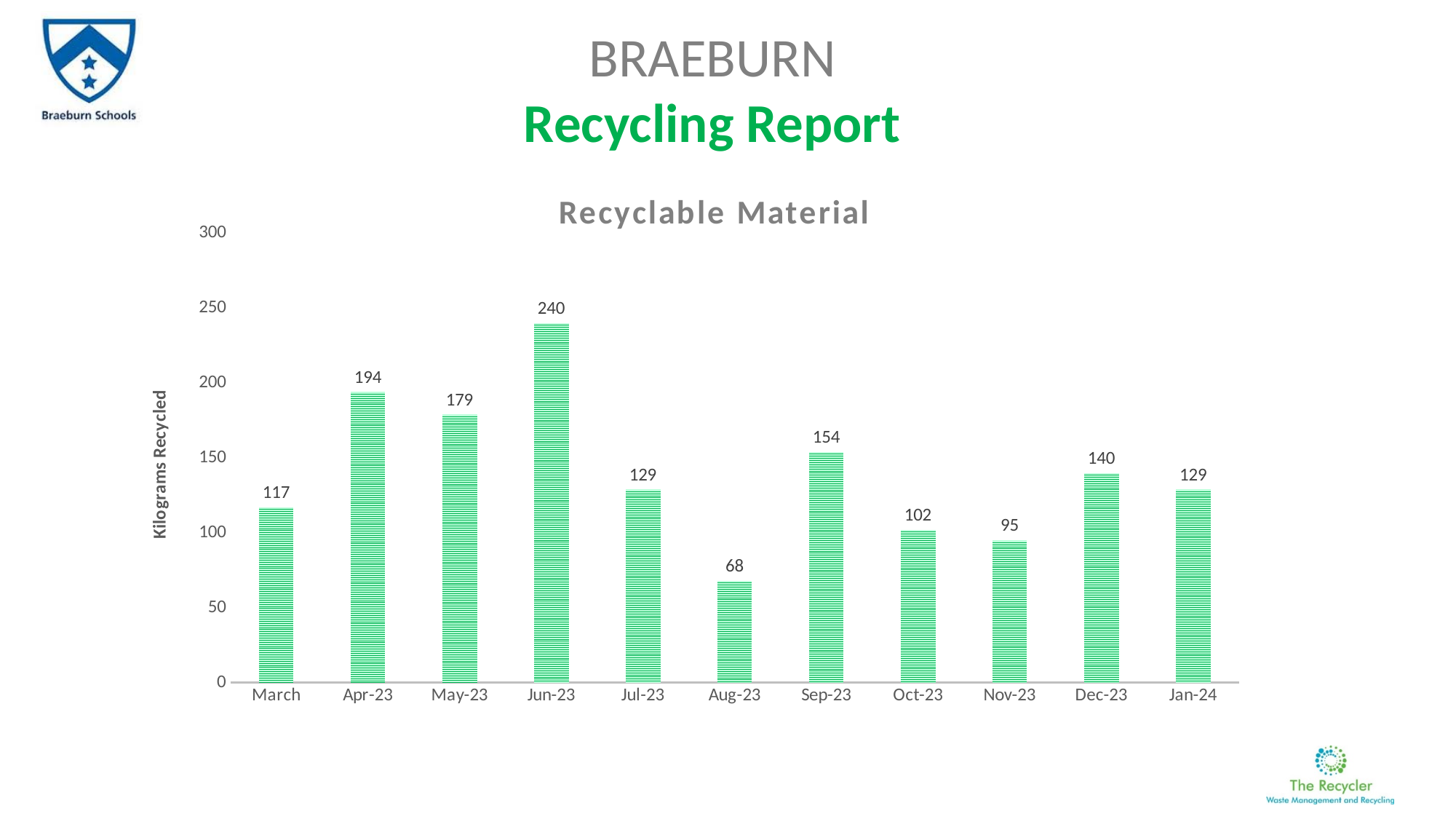
What is the value for Jun-23 in the Recyclable Material chart? 240 How many months are shown on the x axis of the Recyclable Material chart? 11 Do the values rise or fall from Jun-23 to Aug-23? fall Which month has the lowest value in the Recyclable Material chart? Aug-23 What kind of chart is the Recyclable Material chart? bar chart Is the value for Oct-23 greater or less than 150? less Which is larger, the value for Sep-23 or the value for Dec-23? Sep-23 What is the difference between the values for Apr-23 and May-23? 15 What is the value for Nov-23 in the Recyclable Material chart? 95 What is the label on the vertical axis of the chart? Kilograms Recycled What is the title of the chart on the slide? Recyclable Material Which month has the highest value in the Recyclable Material chart? Jun-23